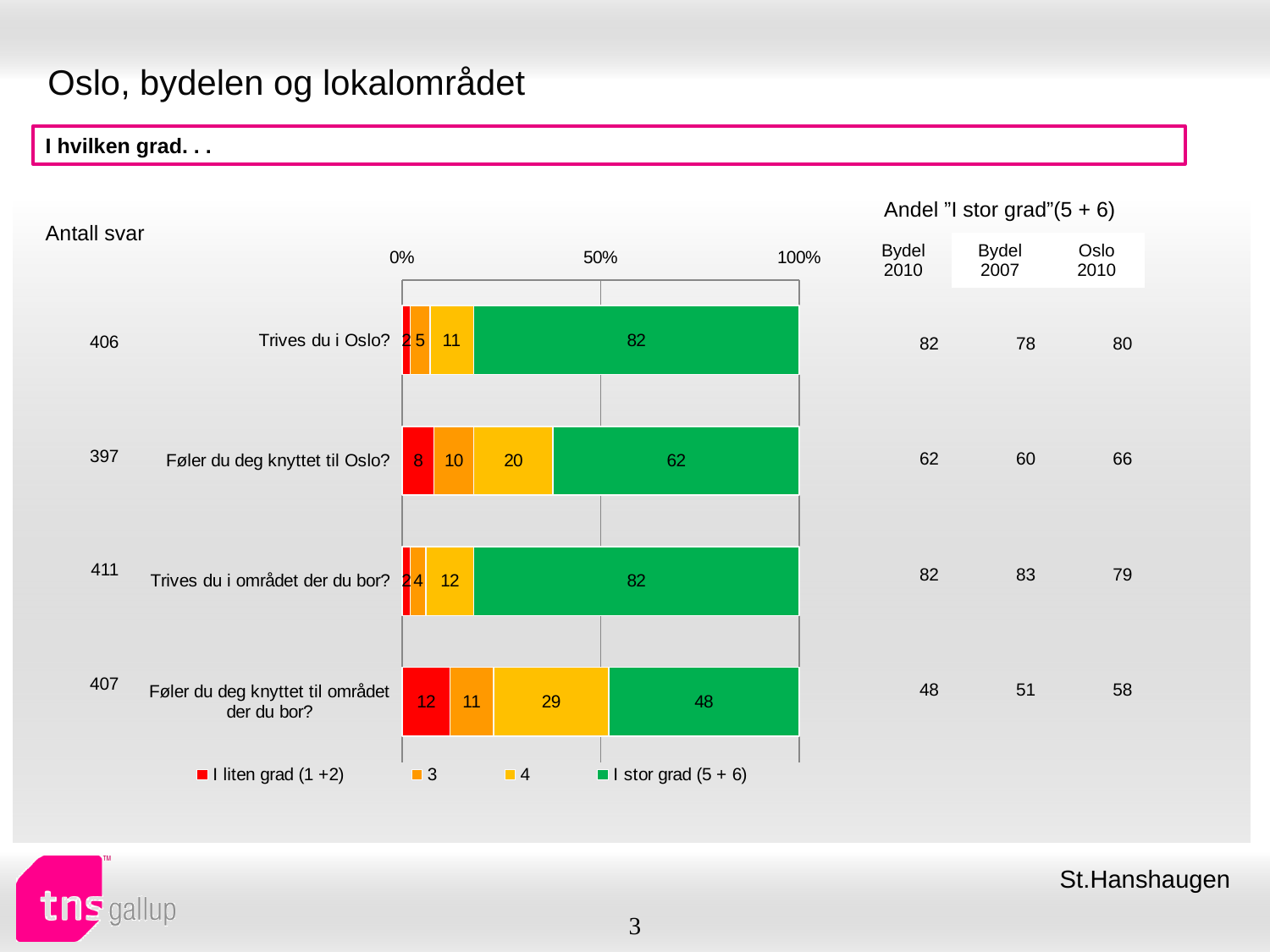
What is the value of "I liten grad (1 +2)" for "Føler du deg knyttet til Oslo?"? 8 What is the value of "I stor grad (5 + 6)" for "Føler du deg knyttet til Oslo?"? 62 What is the difference between the "I stor grad (5 + 6)" values for "Trives du i Oslo?" and "Føler du deg knyttet til Oslo?"? 20 What kind of chart is shown on the slide? Stacked bar chart How many categories (questions) are plotted in the chart? 4 What colour represents "I stor grad (5 + 6)" in the chart? Green Is the "I stor grad (5 + 6)" segment for "Føler du deg knyttet til området der du bor?" greater or less than 50%? less Which category has the lowest value for "I stor grad (5 + 6)"? Føler du deg knyttet til området der du bor? Which is larger: the "4" value for "Føler du deg knyttet til Oslo?" or the "4" value for "Trives du i området der du bor?"? Føler du deg knyttet til Oslo? How many series does the chart legend list? 4 What is the value of "I stor grad (5 + 6)" for "Føler du deg knyttet til området der du bor?"? 48 What is the value of "4" for "Føler du deg knyttet til området der du bor?"? 29